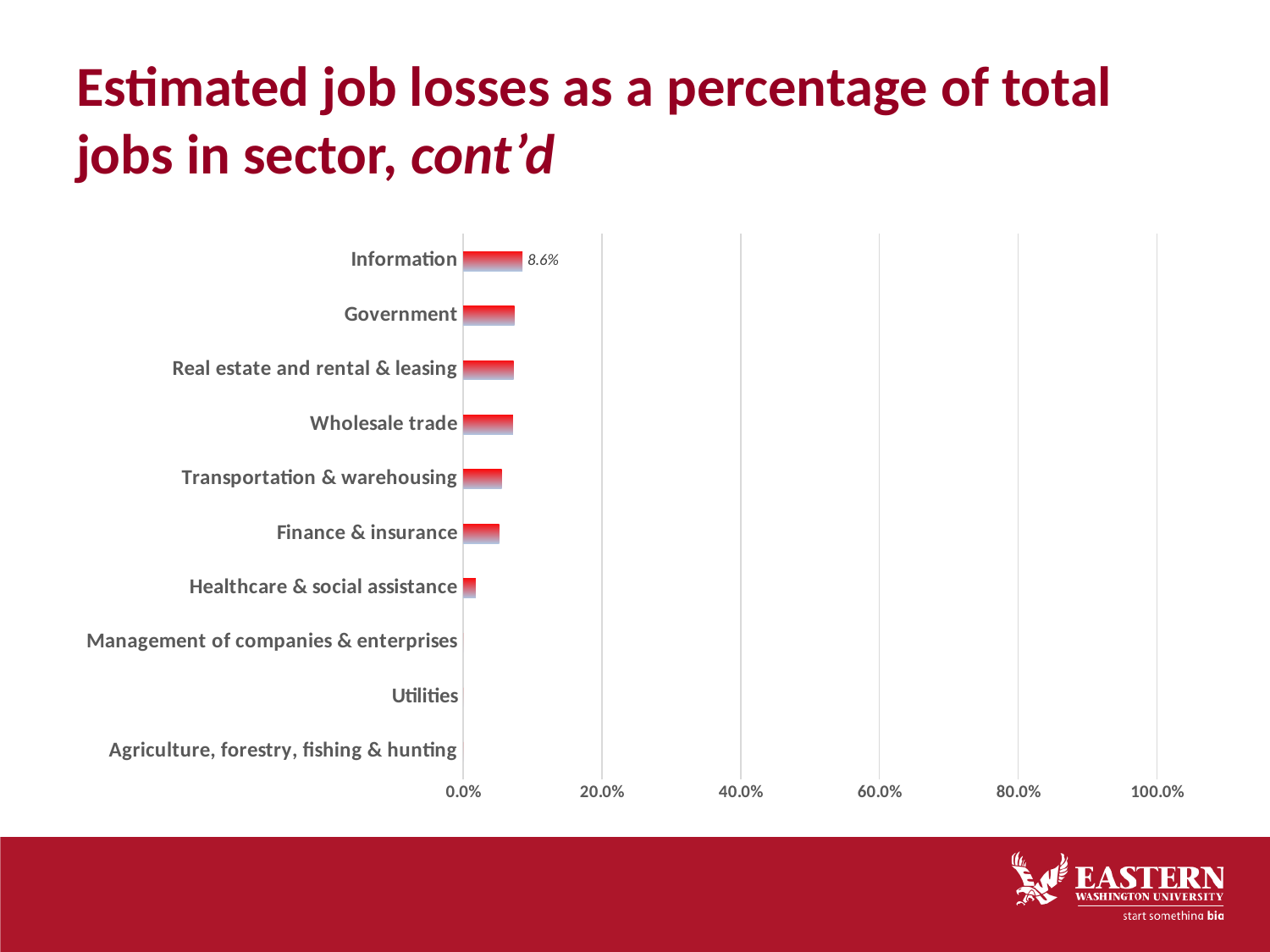
Is the value for Wholesale trade greater or less than 40.0%? less Which sector has the highest estimated job loss percentage? Information Which has a larger estimated job loss percentage, Finance & insurance or Healthcare & social assistance? Finance & insurance What is the highest value shown on the horizontal axis? 100.0% Which has a larger estimated job loss percentage, Information or Transportation & warehousing? Information How many sectors are listed on the chart? 10 Which sector is listed at the bottom of the chart? Agriculture, forestry, fishing & hunting Among the sectors with a visible bar, which has the lowest estimated job loss percentage? Healthcare & social assistance What is the estimated job loss percentage for the Information sector? 8.6% What kind of chart is shown on the slide? Bar chart Is the value for Government greater or less than 20.0%? less